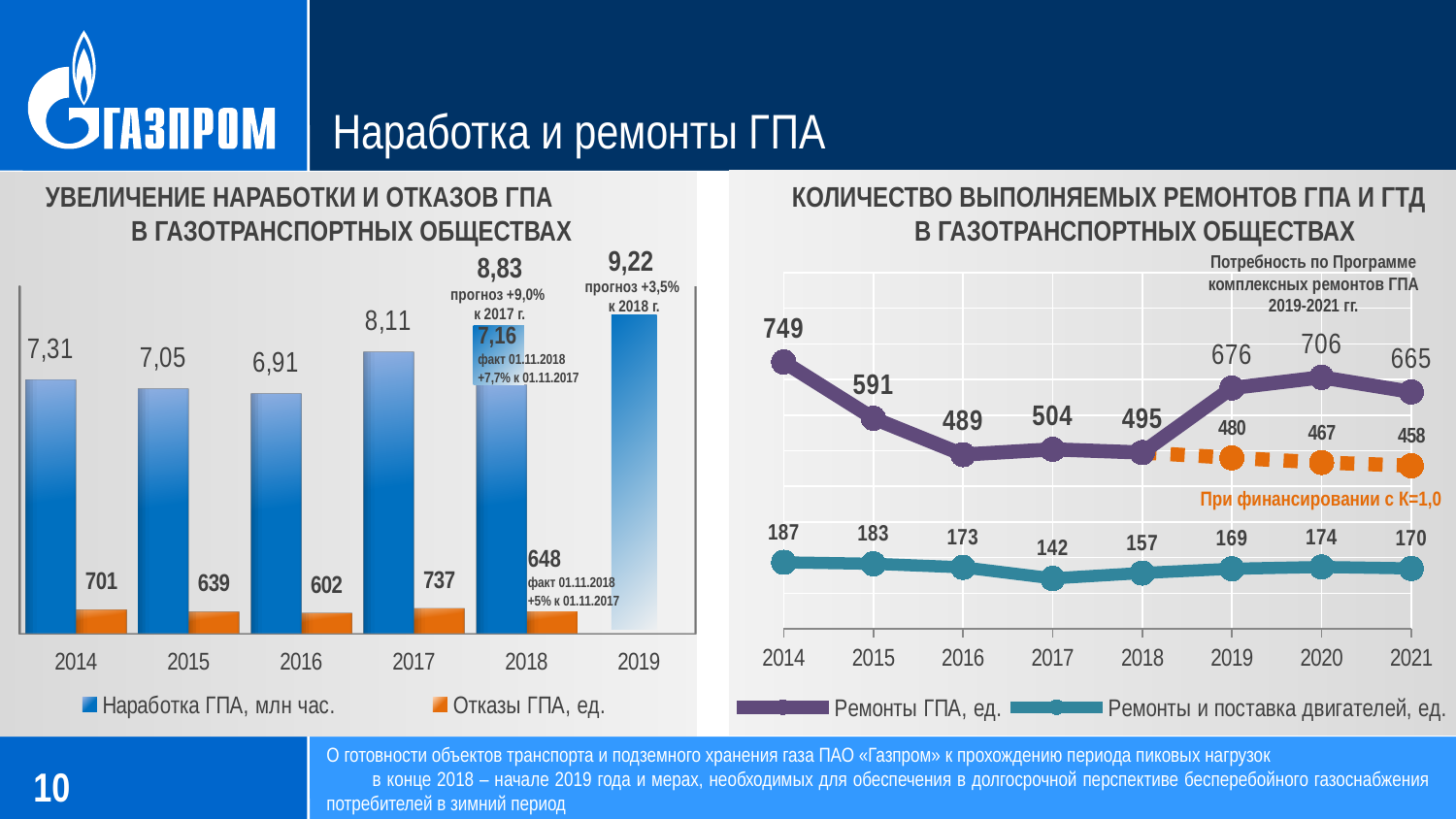
On the left chart, what is the value of Наработка ГПА for 2017? 8,11 On the left chart, what is the value of Отказы ГПА for 2015? 639 On the right chart, which is larger: Ремонты ГПА in 2020 or in 2021? 2020 On the right chart, what is the value of Ремонты ГПА for 2014? 749 What type of chart is the left chart? Bar chart On the left chart, what is the difference between Отказы ГПА in 2014 and 2016? 99 On the left chart, which year has the highest value of Отказы ГПА? 2017 On the right chart, how many years are shown on the x axis? 8 On the right chart, which year has the lowest value of Ремонты и поставка двигателей? 2017 How many series does the legend of the right chart list? 2 On the right chart, what is the value of Ремонты и поставка двигателей for 2017? 142 On the left chart, which year from 2014 to 2017 has the lowest value of Наработка ГПА? 2016